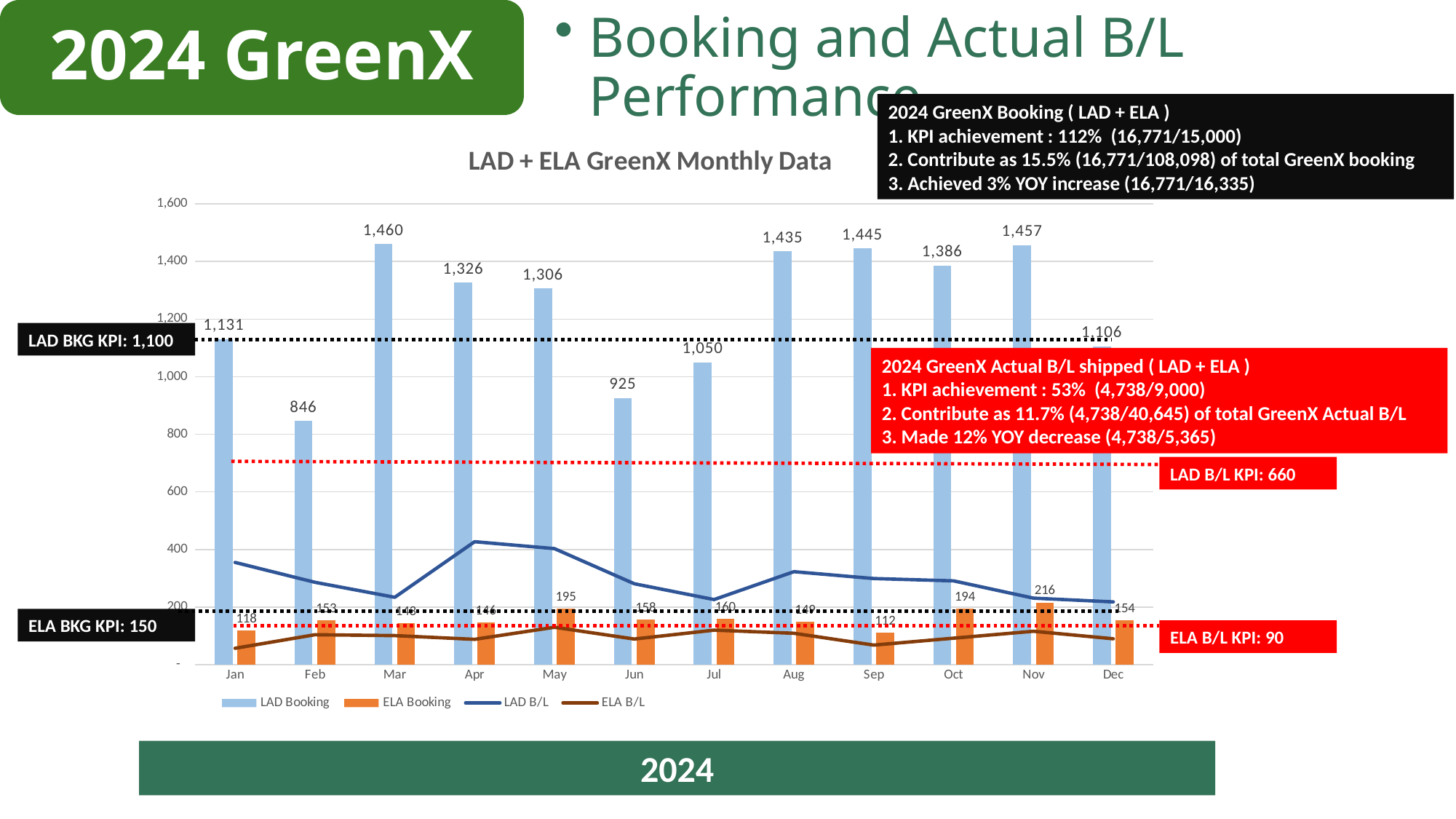
Which month has the lowest LAD Booking value? Feb What is the title of the chart? LAD + ELA GreenX Monthly Data Which month has the highest ELA Booking value? Nov How many series does the legend list? 4 Which month has the larger LAD Booking value, Aug or Sep? Sep Which month has the highest LAD Booking value? Mar How many months are shown on the x axis? 12 What is the ELA Booking value for May? 195 What is the LAD Booking value for Mar? 1,460 What is the LAD Booking value for Jun? 925 Is the LAD B/L value for Jan greater or less than 400? less What is the difference between the LAD Booking values for Mar and Feb? 614